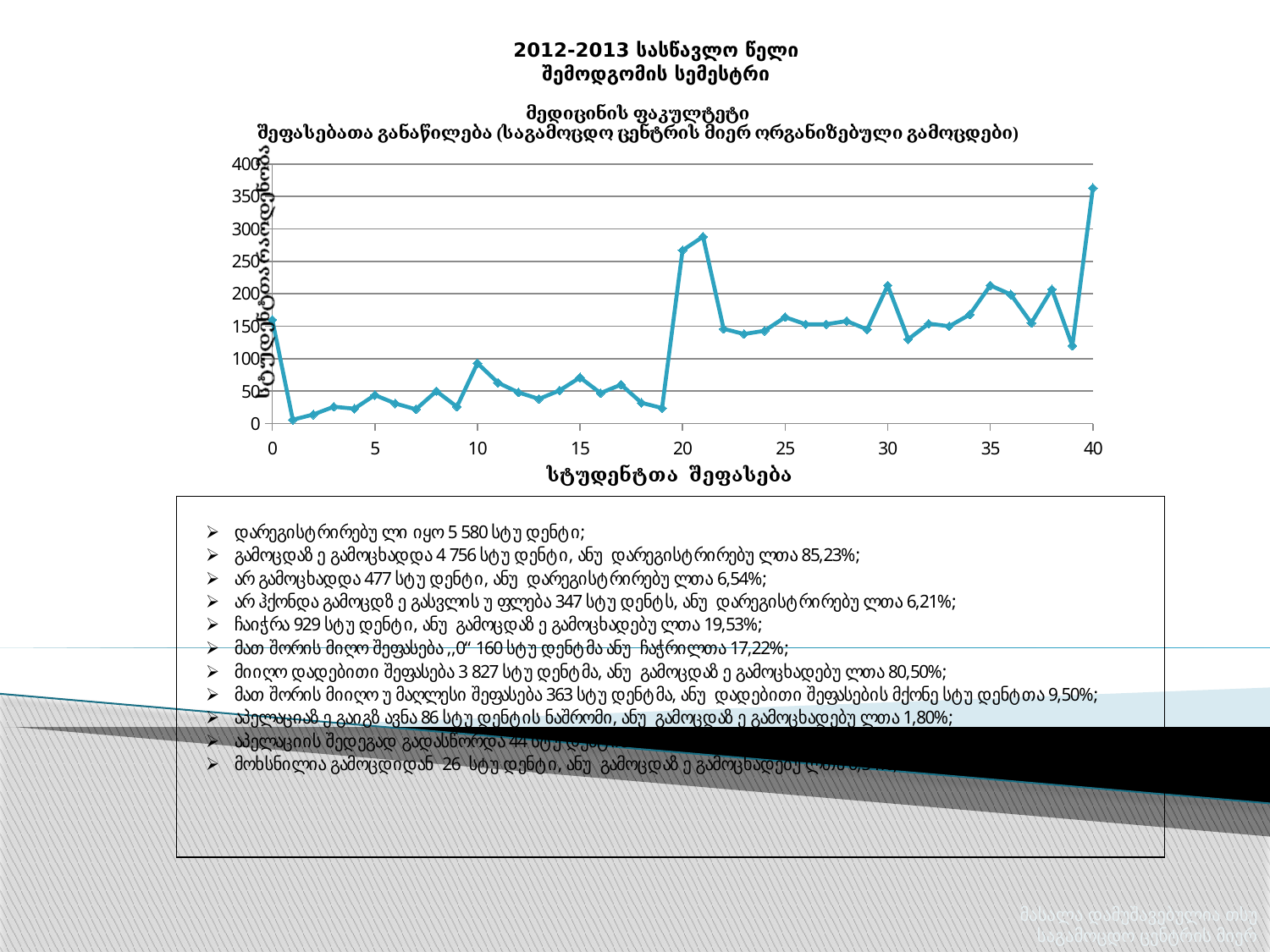
At which x-axis value (student score) does the line reach its highest point? 40 Which score has more students, 21 or 22? 21 Is the number of students at score 20 greater or less than 250? greater What kind of chart is shown on the slide? line chart At which x-axis value (student score) does the line reach its lowest point? 1 How many lines (data series) are plotted on the chart? 1 Does the line rise or fall between score 0 and score 1? fall Is the number of students at score 1 greater or less than 50? less Is the number of students at score 40 greater or less than 300? greater Which score has more students, 9 or 10? 10 What is the label of the x axis of the chart? სტუდენტთა შეფასება